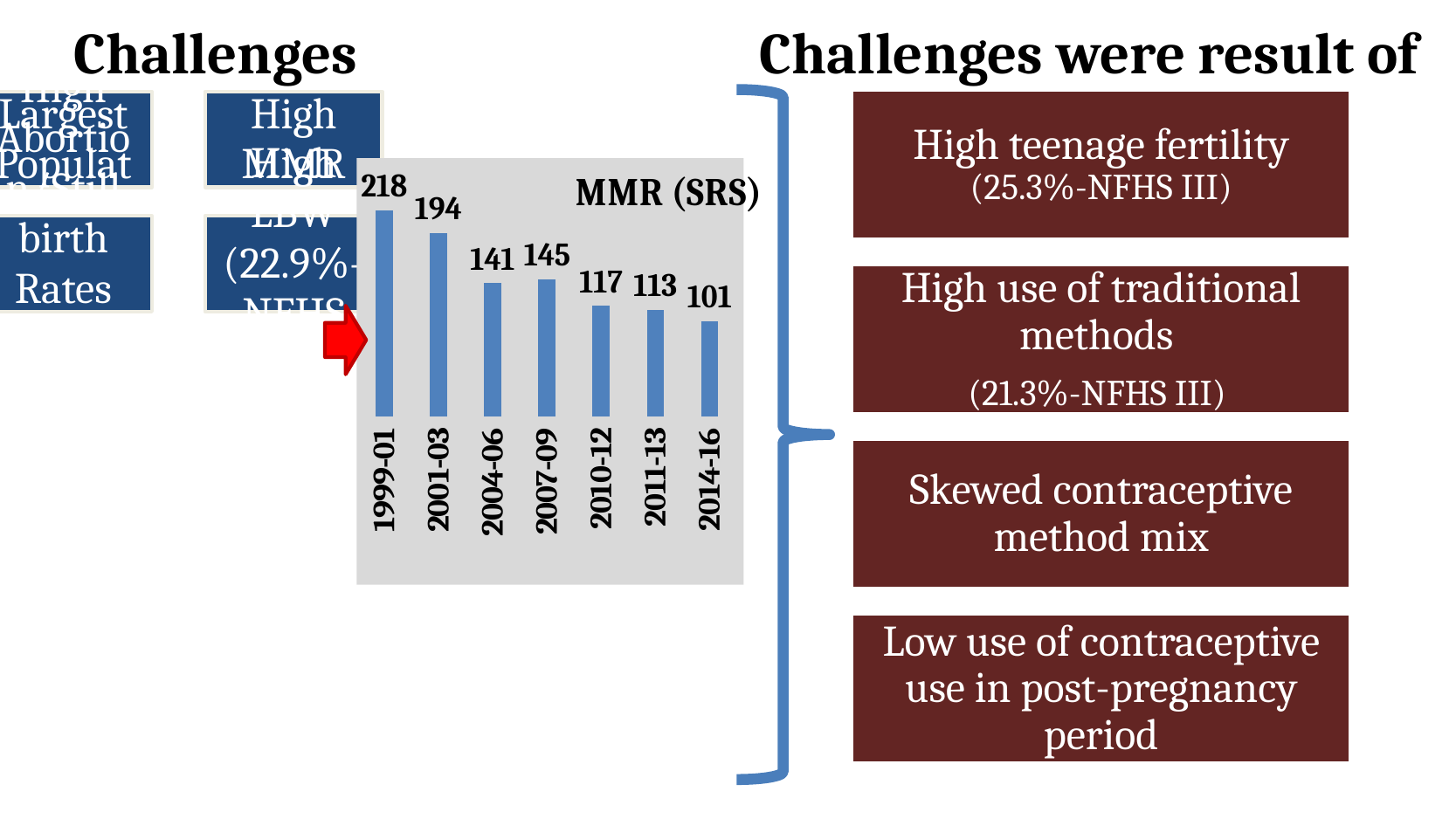
What is the difference between the MMR (SRS) values for 2001-03 and 2004-06? 53 Which is larger, the MMR (SRS) value for 2010-12 or for 2011-13? 2010-12 What kind of chart is the MMR (SRS) chart? Bar chart Which period has the lowest MMR (SRS) value? 2014-16 What is the difference between the MMR (SRS) values for 1999-01 and 2014-16? 117 What is the MMR (SRS) value for 2014-16? 101 What is the title of the chart on the slide? MMR (SRS) What is the MMR (SRS) value for 2007-09? 145 Which period has the highest MMR (SRS) value? 1999-01 What is the MMR (SRS) value for 1999-01? 218 How many periods are shown in the MMR (SRS) chart? 7 Which is larger, the MMR (SRS) value for 2004-06 or for 2007-09? 2007-09